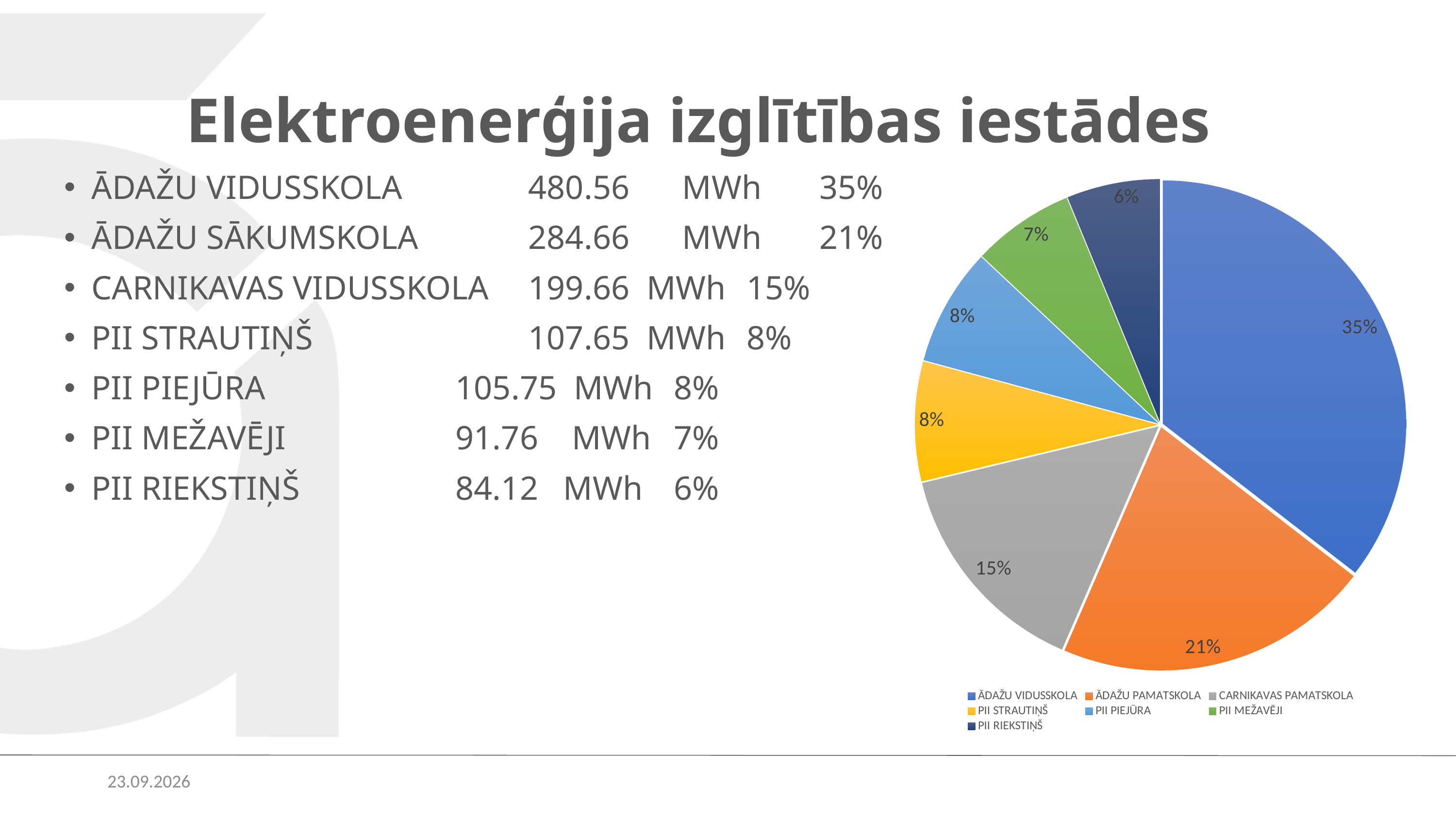
What share of the pie does ĀDAŽU VIDUSSKOLA have? 35% By how many percentage points does the ĀDAŽU VIDUSSKOLA slice exceed the ĀDAŽU PAMATSKOLA slice? 14 percentage points What kind of chart is shown on the slide? pie chart What share of the pie does CARNIKAVAS PAMATSKOLA have? 15% Which category has the largest slice of the pie chart? ĀDAŽU VIDUSSKOLA What share of the pie does ĀDAŽU PAMATSKOLA have? 21% What colour is the ĀDAŽU PAMATSKOLA slice in the pie chart? orange Which category has the smallest slice of the pie chart? PII RIEKSTIŅŠ What share of the pie does PII RIEKSTIŅŠ have? 6% Which slice is larger, CARNIKAVAS PAMATSKOLA or PII MEŽAVĒJI? CARNIKAVAS PAMATSKOLA How many slices does the pie chart have? 7 What share of the pie does PII MEŽAVĒJI have? 7%